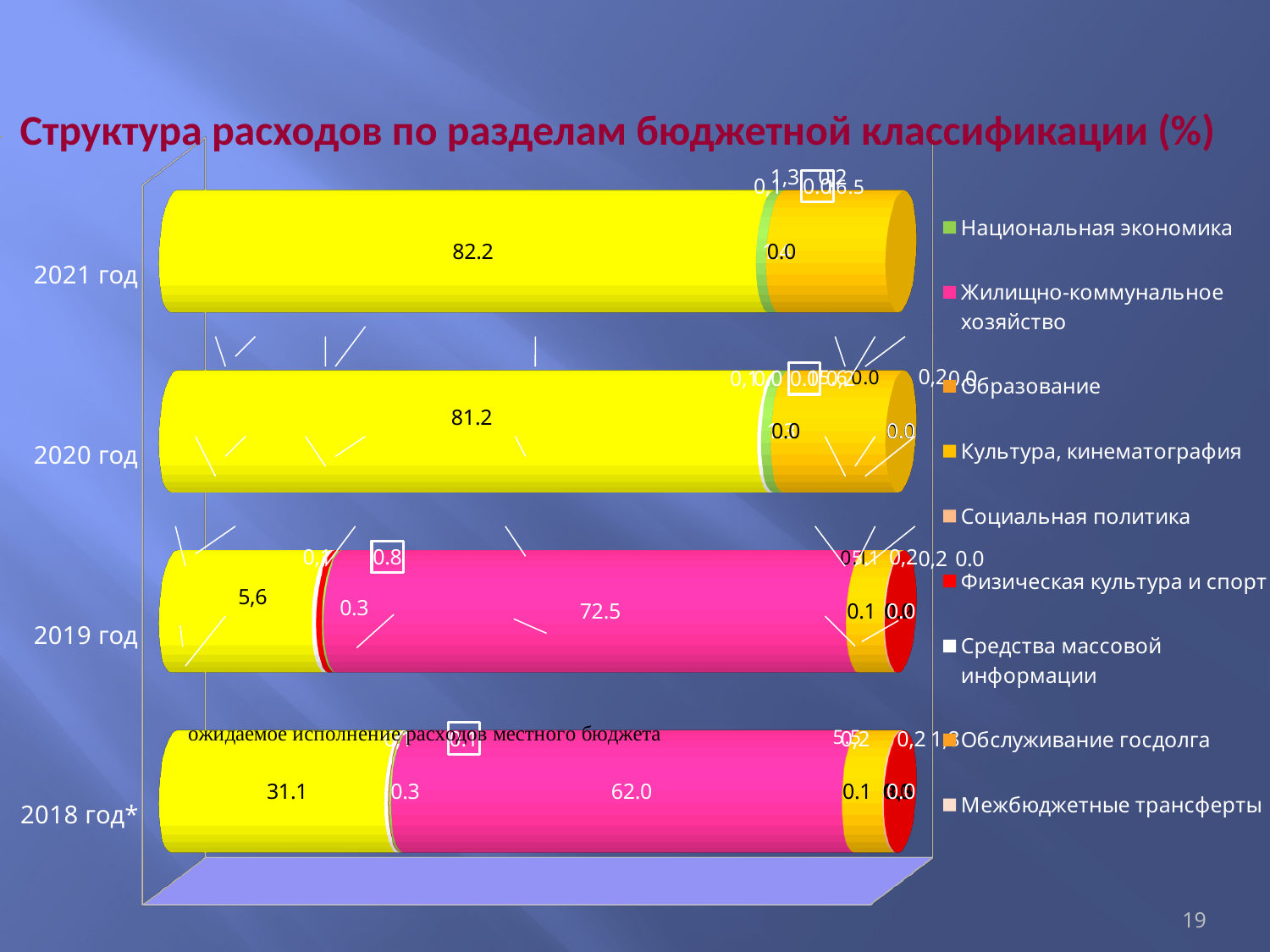
How many year categories are plotted on the chart? 4 What is the value printed on the large yellow segment of the 2021 год bar? 82.2 What kind of chart is shown on the slide? bar chart What is the value printed on the pink segment of the 2018 год* bar? 62.0 What is the value printed on the pink segment of the 2019 год bar? 72.5 What is the value printed on the yellow segment of the 2018 год* bar? 31.1 Which year has the larger value on its yellow segment, 2021 год or 2020 год? 2021 год What is the value printed on the large yellow segment of the 2020 год bar? 81.2 What is the title of the chart on the slide? Структура расходов по разделам бюджетной классификации (%) How many series does the chart legend list? 9 What is the difference between the yellow segment values for 2021 год (82.2) and 2020 год (81.2)? 1.0 What is the difference between the pink segment values for 2019 год (72.5) and 2018 год* (62.0)? 10.5